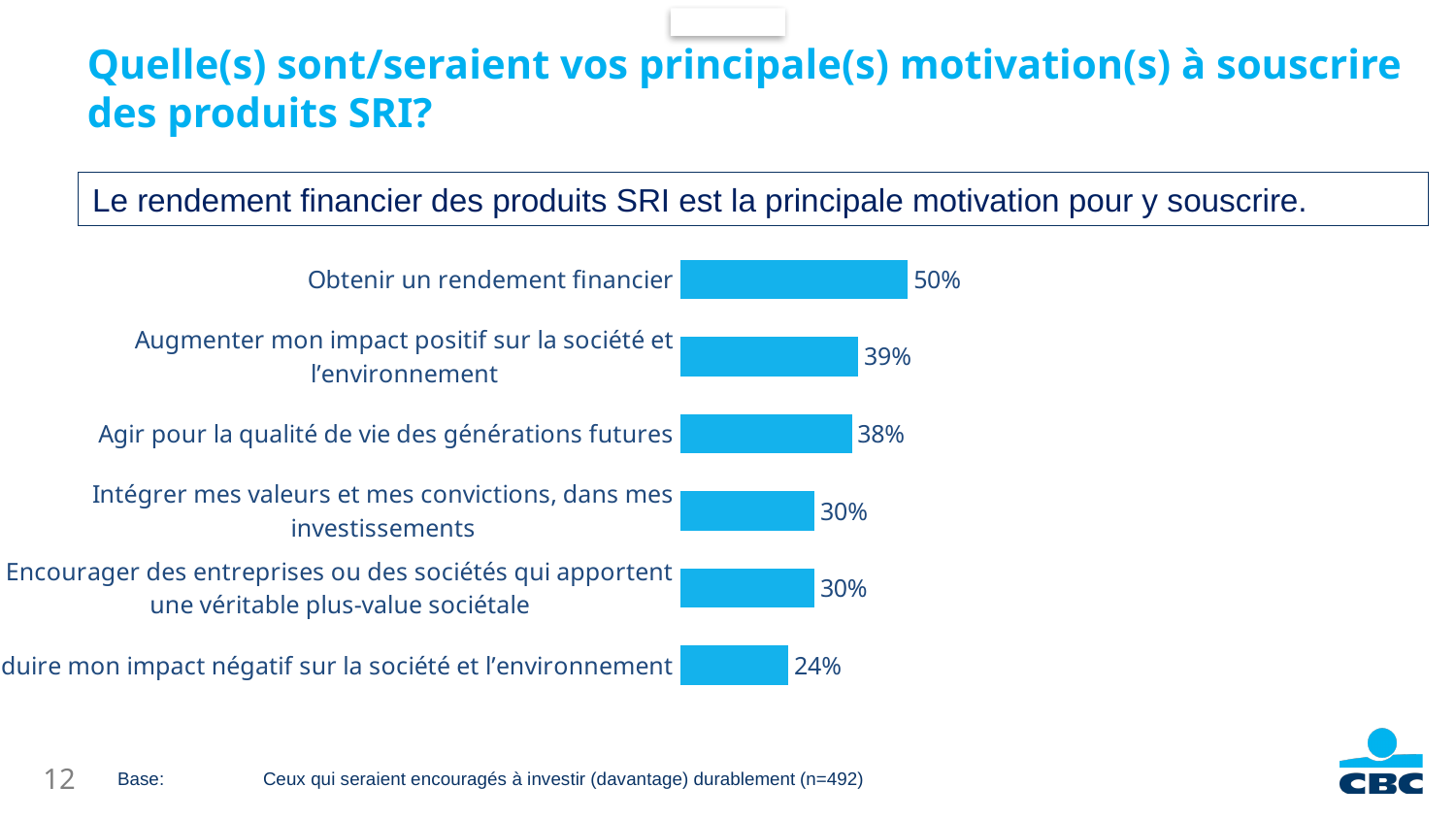
What is the value for "Obtenir un rendement financier"? 50% What is the value for "Agir pour la qualité de vie des générations futures"? 38% What is the value shown for the bottom bar of the chart? 24% What type of chart is shown on the slide? bar chart What is the value for "Intégrer mes valeurs et mes convictions, dans mes investissements"? 30% Which is larger: the value for "Agir pour la qualité de vie des générations futures" or the value for "Encourager des entreprises ou des sociétés qui apportent une véritable plus-value sociétale"? Agir pour la qualité de vie des générations futures What is the difference between the value for "Obtenir un rendement financier" and the value for "Augmenter mon impact positif sur la société et l'environnement"? 11% What is the difference between the value for "Intégrer mes valeurs et mes convictions, dans mes investissements" and the value for the bottom bar? 6% How many categories (bars) does the chart show? 6 What is the sample size (n) given in the base note below the chart? 492 Which category has the highest value? Obtenir un rendement financier What is the value for "Augmenter mon impact positif sur la société et l'environnement"? 39%